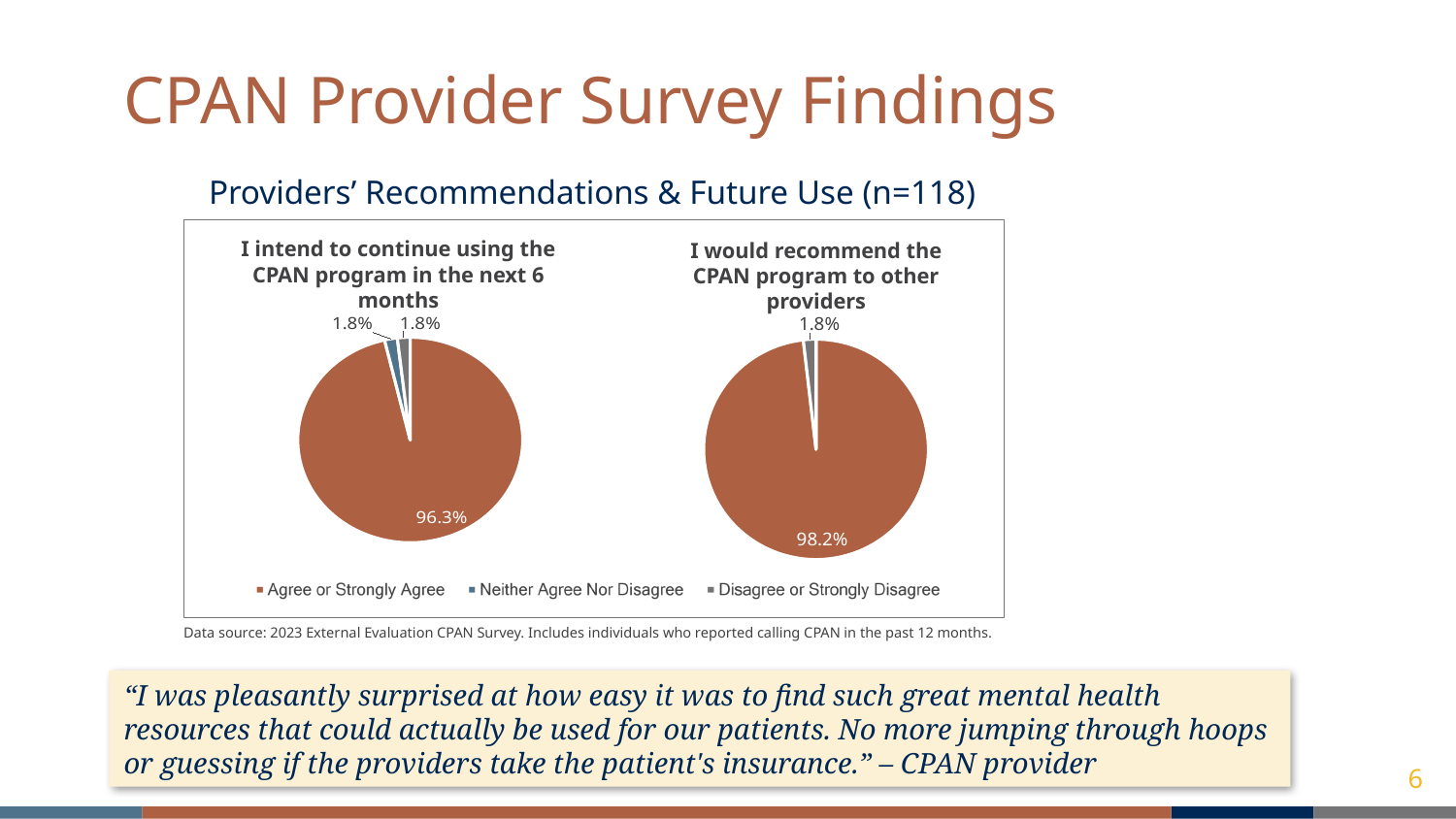
In the pie chart titled "I intend to continue using the CPAN program in the next 6 months", what share of providers chose Agree or Strongly Agree? 96.3% Which chart shows a larger Agree or Strongly Agree share: the left pie chart (continue using) or the right pie chart (recommend to other providers)? The right pie chart (recommend to other providers) What is the sample size (n) stated in the heading above the charts? 118 How many slices does the pie chart titled "I would recommend the CPAN program to other providers" have? 2 How many slices does the pie chart titled "I intend to continue using the CPAN program in the next 6 months" have? 3 In the pie chart titled "I would recommend the CPAN program to other providers", what is the value of the small slice? 1.8% How many categories does the shared legend list? 3 In the pie chart titled "I intend to continue using the CPAN program in the next 6 months", which category has the largest slice? Agree or Strongly Agree In the pie chart titled "I would recommend the CPAN program to other providers", what share of providers chose Agree or Strongly Agree? 98.2% What is the difference between the Agree or Strongly Agree share in the right pie chart (98.2%) and in the left pie chart (96.3%)? 1.9 percentage points What type of charts are shown on the slide? Pie charts In the pie chart titled "I intend to continue using the CPAN program in the next 6 months", what share of providers chose Neither Agree Nor Disagree? 1.8%